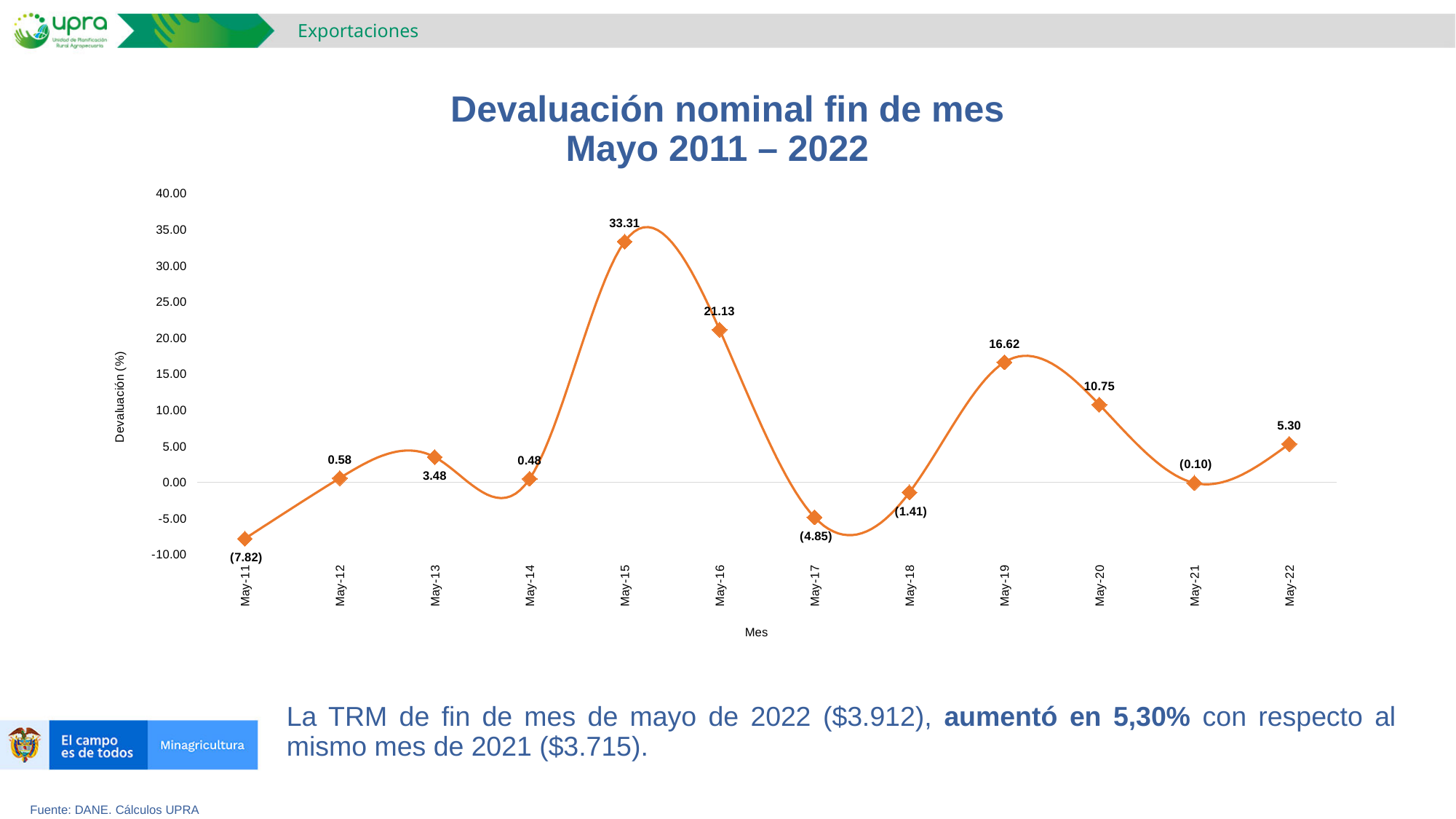
What kind of chart is shown on the slide? Line chart Which month has the lowest devaluation value? May-11 How many data points are plotted on the chart? 12 What is the devaluation value for May-15? 33.31 What is the difference between the values for May-15 and May-16? 12.18 What is the devaluation value for May-19? 16.62 What is the devaluation value for May-22? 5.30 What is the title of the chart? Devaluación nominal fin de mes Mayo 2011 – 2022 What is the devaluation value for May-11? (7.82) Is the value for May-16 greater or less than 20.00? greater Which is larger, the value for May-19 or the value for May-20? May-19 Which month has the highest devaluation value? May-15